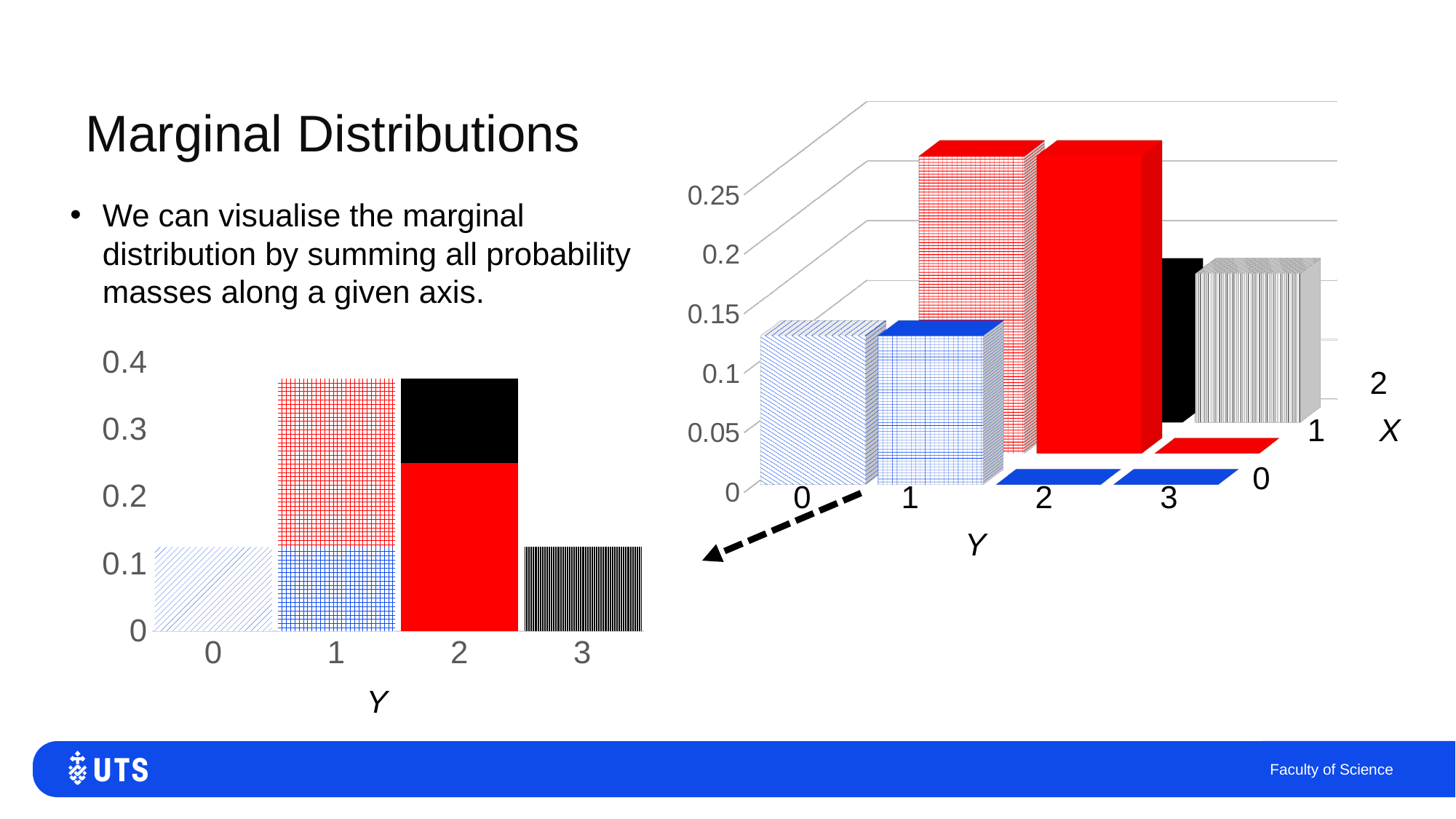
In the left chart, is the value for Y = 3 greater or less than 0.2? less In the left chart, which bar is taller, Y = 1 or Y = 0? Y = 1 In the left chart, is the total height of the stacked bar for Y = 1 greater or less than 0.3? greater In the right 3D chart, is the red bar at Y = 2 greater or less than 0.2? greater How many categories are shown on the X axis of the right 3D chart? 3 In the left chart, which bar is taller, Y = 2 or Y = 3? Y = 2 How many categories are shown on the Y axis of the left chart? 4 What kind of chart is the chart on the left of the slide? bar chart What is the label on the horizontal axis of the left chart? Y